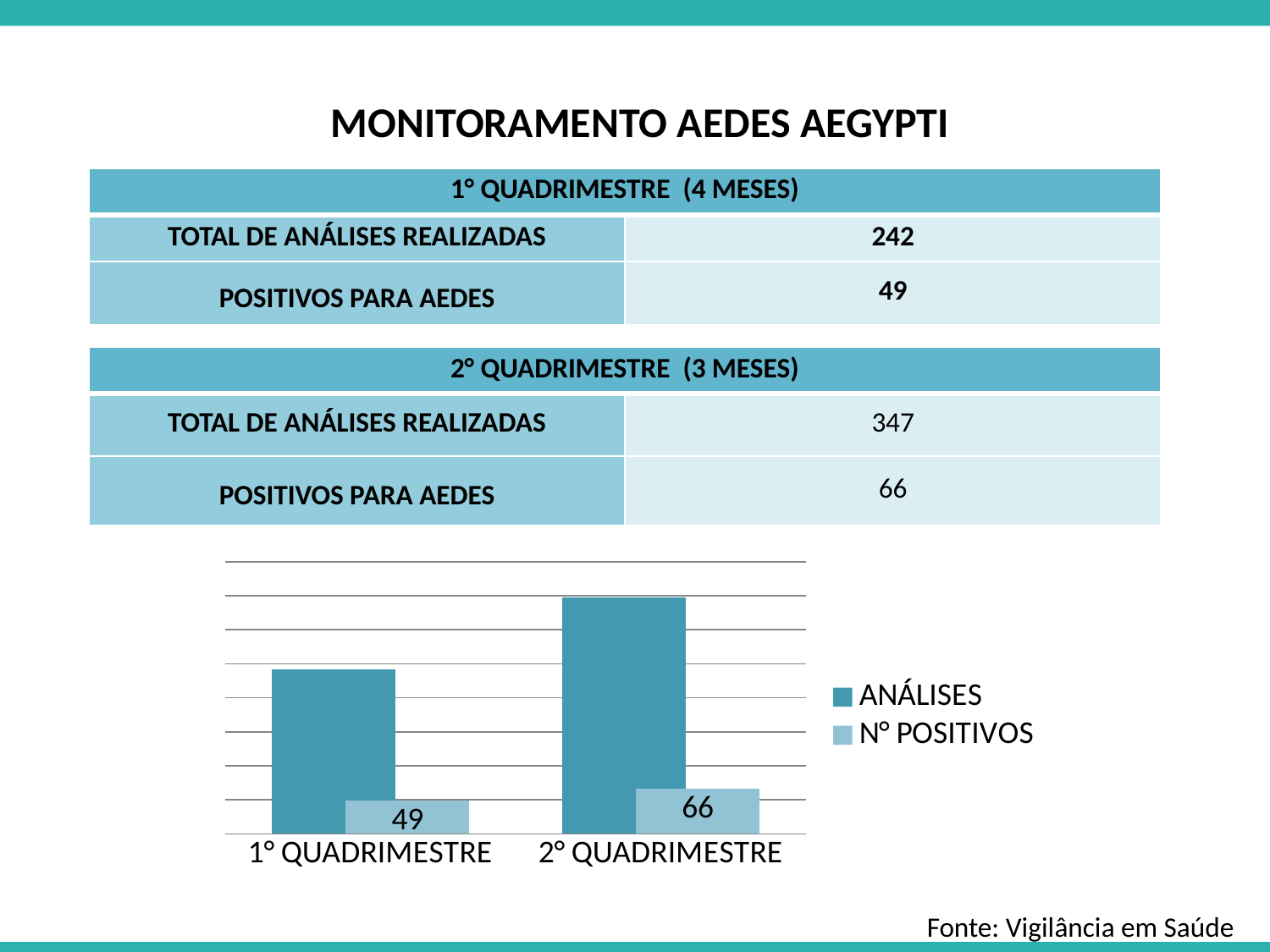
What are the two series names listed in the chart legend? ANÁLISES and N° POSITIVOS What type of chart is shown on the slide? bar chart How many series does the chart legend list? 2 Do the N° POSITIVOS values rise or fall from 1° QUADRIMESTRE to 2° QUADRIMESTRE? rise Which series in the chart is shown in the darker blue colour? ANÁLISES Is the ANÁLISES bar taller for 1° QUADRIMESTRE or 2° QUADRIMESTRE? 2° QUADRIMESTRE What is the N° POSITIVOS value for 1° QUADRIMESTRE in the chart? 49 Which category has the higher N° POSITIVOS value in the chart? 2° QUADRIMESTRE What is the difference between the N° POSITIVOS values for 2° QUADRIMESTRE and 1° QUADRIMESTRE? 17 How many categories are shown on the x axis of the chart? 2 Which category has the lower N° POSITIVOS value in the chart? 1° QUADRIMESTRE What is the N° POSITIVOS value for 2° QUADRIMESTRE in the chart? 66